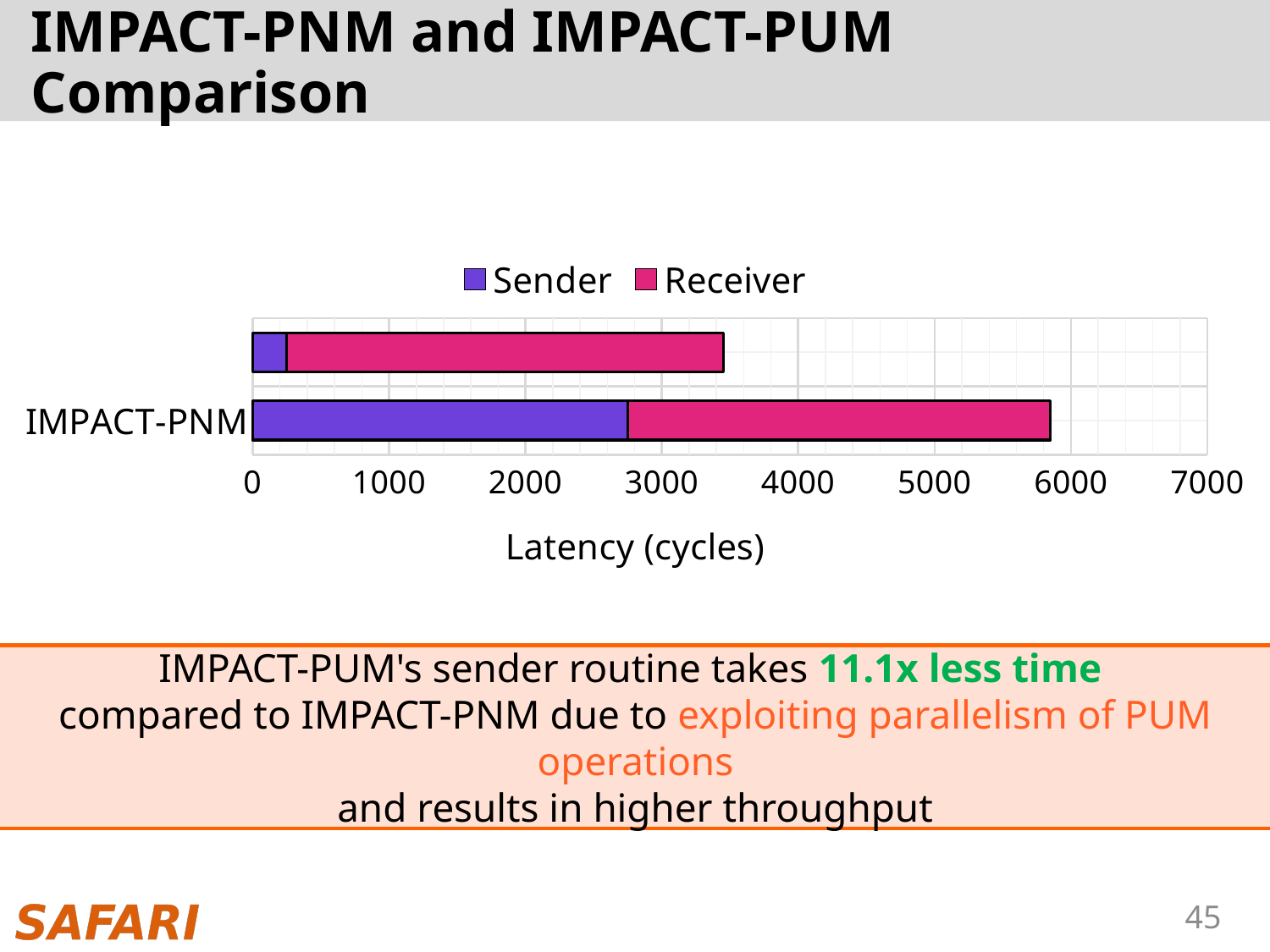
Is the Receiver latency for IMPACT-PNM greater or less than 2000 cycles? greater Is the Sender latency for IMPACT-PNM greater or less than 3000 cycles? less Is the total latency for IMPACT-PNM greater or less than 5000 cycles? greater What type of chart is shown on the slide? Bar chart How many bars are plotted in the chart? 2 How many series does the legend list? 2 What are the two series named in the legend? Sender and Receiver For IMPACT-PNM, which segment is larger, Sender or Receiver? Receiver What is the title of the x axis? Latency (cycles)